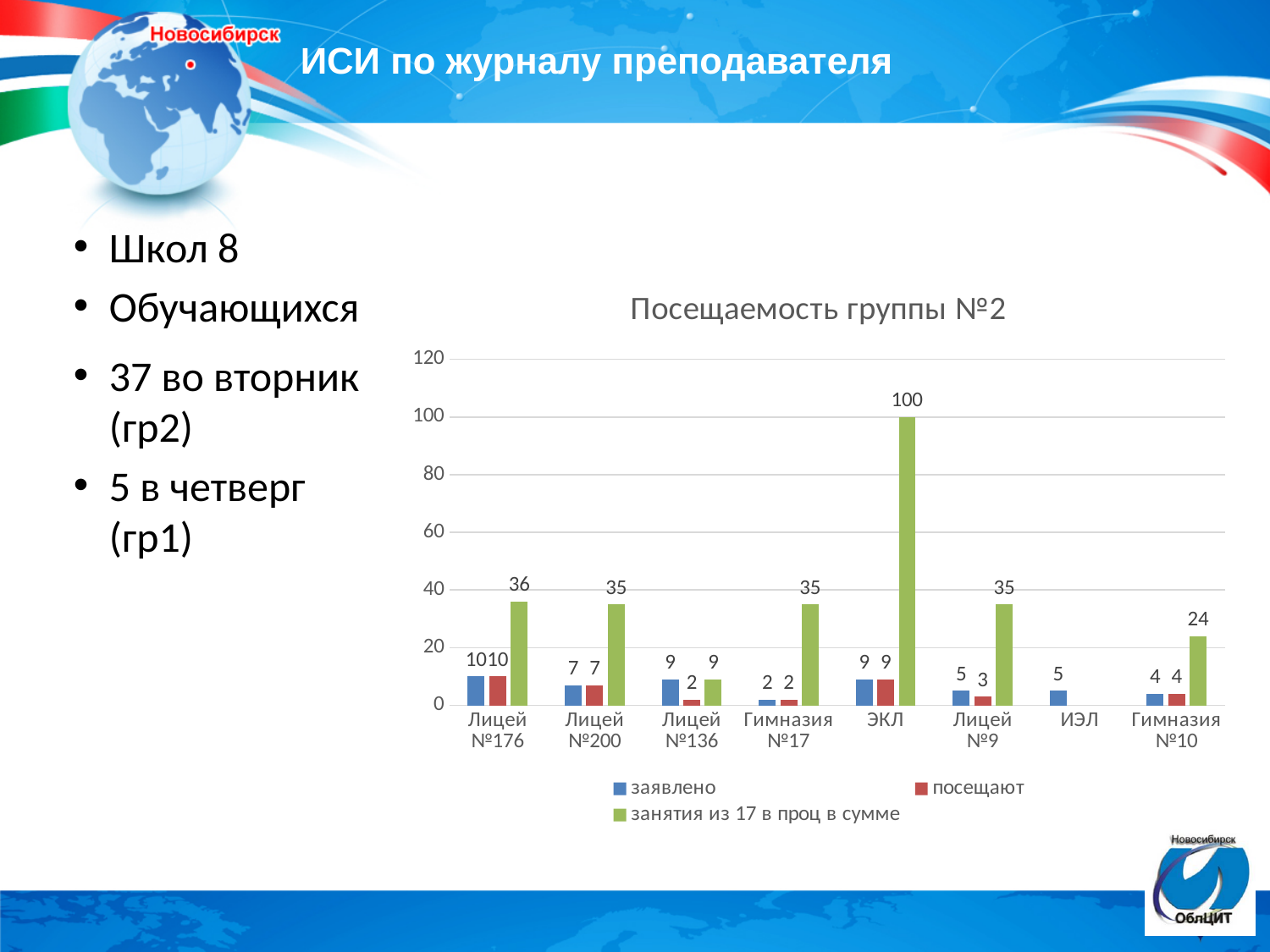
What is the value of 'занятия из 17 в проц в сумме' for ЭКЛ? 100 Which is larger: 'занятия из 17 в проц в сумме' for Лицей №176 or for Гимназия №10? Лицей №176 What is the title of the chart on the slide? Посещаемость группы №2 Which category has the highest value for 'занятия из 17 в проц в сумме'? ЭКЛ Which category has the lowest value for 'заявлено'? Гимназия №17 How many categories are shown on the x axis of the chart? 8 What is the value of 'посещают' for Лицей №9? 3 Is the value of 'занятия из 17 в проц в сумме' for ЭКЛ greater or less than 80? greater What is the difference between 'заявлено' and 'посещают' for Лицей №136? 7 What kind of chart is shown on the slide? bar chart How many series does the chart legend list? 3 What is the value of 'заявлено' for Лицей №136? 9